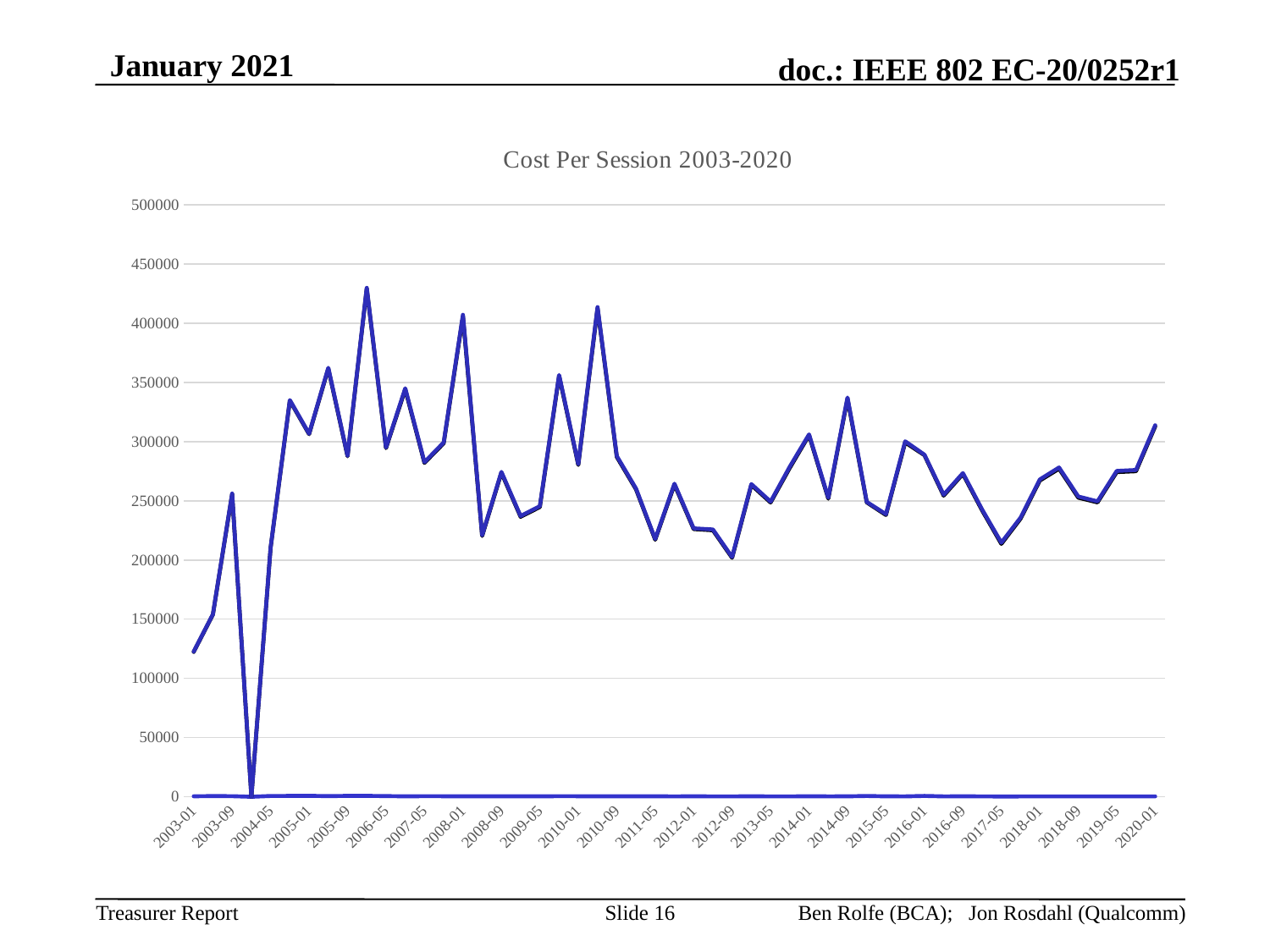
Is the value for 2003-01 greater or less than 150000? less What kind of chart is shown on the slide? line chart What is the highest value shown on the vertical axis? 500000 Is the value for 2014-09 greater or less than 300000? greater Does the line rise or fall between 2019-05 and 2020-01? rise Is the value for 2020-01 greater or less than 300000? greater Which is larger, the value for 2003-01 or the value for 2020-01? 2020-01 What is the title of the chart? Cost Per Session 2003-2020 Does the line rise or fall between 2003-01 and 2003-09? rise